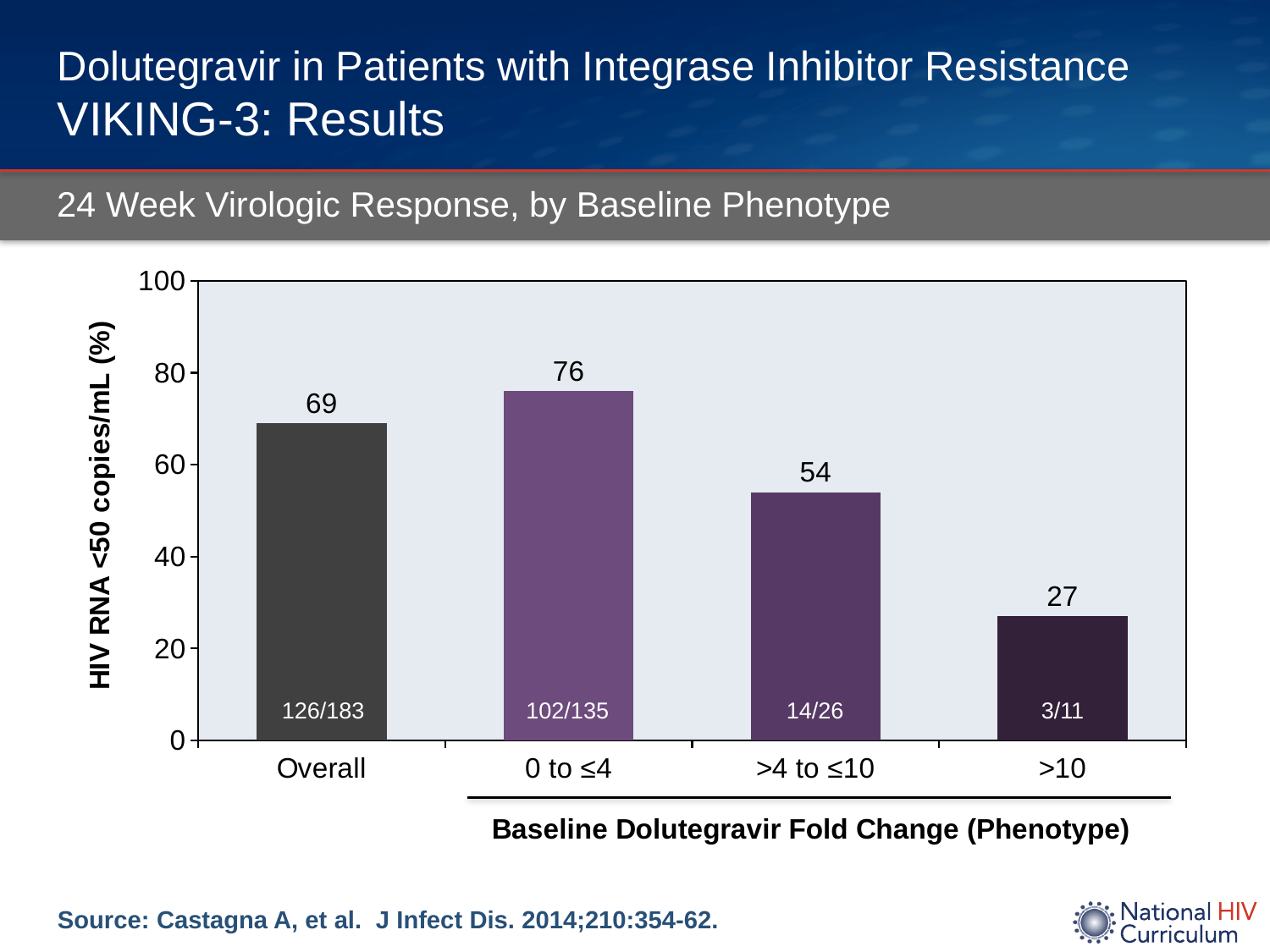
What is the value for the >10 fold change category? 27 What kind of chart is shown on the slide? Bar chart What is the value for the 0 to ≤4 fold change category? 76 What is the label of the y axis? HIV RNA <50 copies/mL (%) Which category has the highest value? 0 to ≤4 What is the value for the >4 to ≤10 fold change category? 54 What fraction is printed inside the bar for the >4 to ≤10 category? 14/26 What is the value for the Overall category? 69 What is the difference between the values for 0 to ≤4 and >10? 49 Which is larger, the value for Overall or the value for >4 to ≤10? Overall How many bars are shown in the chart? 4 Which category has the lowest value? >10